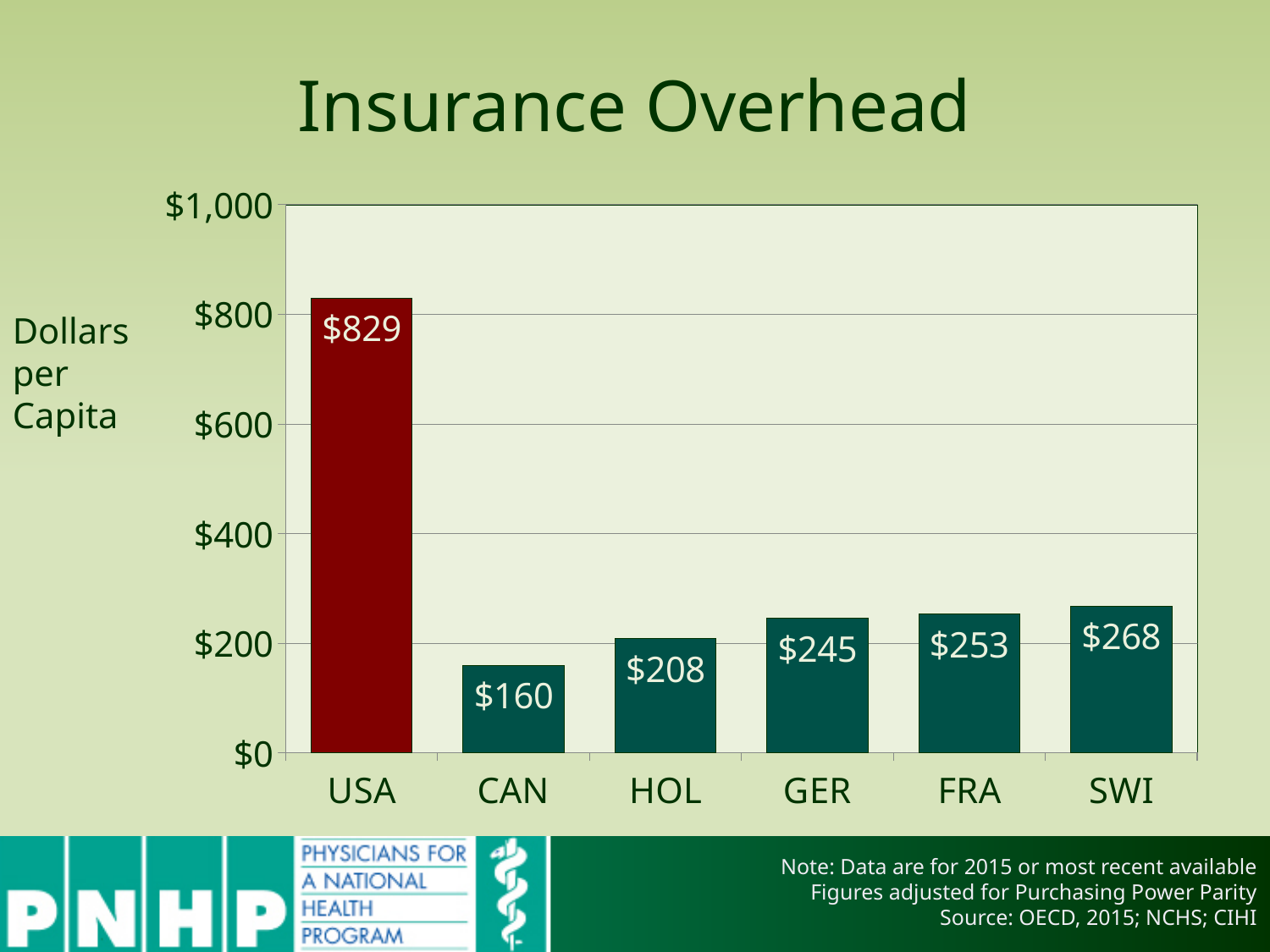
Which country has the highest insurance overhead? USA Is the value for USA greater or less than $800? greater What is the title of the chart? Insurance Overhead Which country has the lowest insurance overhead? CAN What is the insurance overhead value for GER? $245 What is the difference between the SWI and HOL values? $60 How many countries are shown on the chart? 6 What kind of chart is shown on the slide? bar chart What is the insurance overhead value for USA? $829 What is the insurance overhead value for CAN? $160 What is the difference between the USA and CAN values? $669 Which is larger, the value for FRA or the value for HOL? FRA